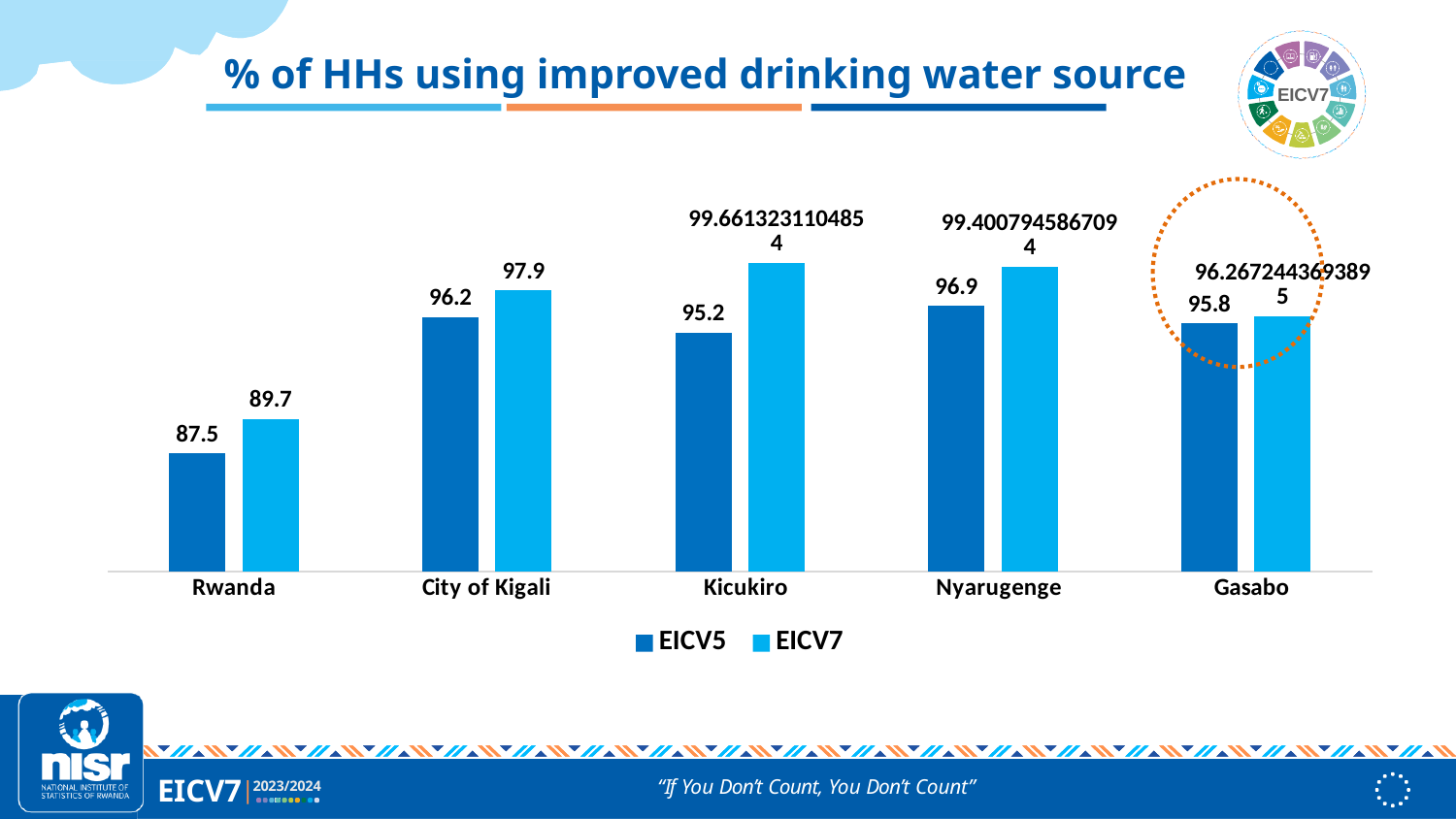
What is the difference between the EICV7 and EICV5 values for City of Kigali? 1.7 Which category has the lowest EICV5 value? Rwanda Which is larger, the EICV7 value for Kicukiro or the EICV7 value for Gasabo? Kicukiro What is the EICV7 value for City of Kigali? 97.9 Which category has the highest EICV5 value? Nyarugenge What is the EICV5 value for Rwanda? 87.5 What is the EICV5 value for Kicukiro? 95.2 What kind of chart is shown on the slide? Bar chart How many series does the legend list? 2 What is the difference between the EICV7 and EICV5 values for Rwanda? 2.2 What is the EICV5 value for Gasabo? 95.8 How many categories are shown on the x axis? 5